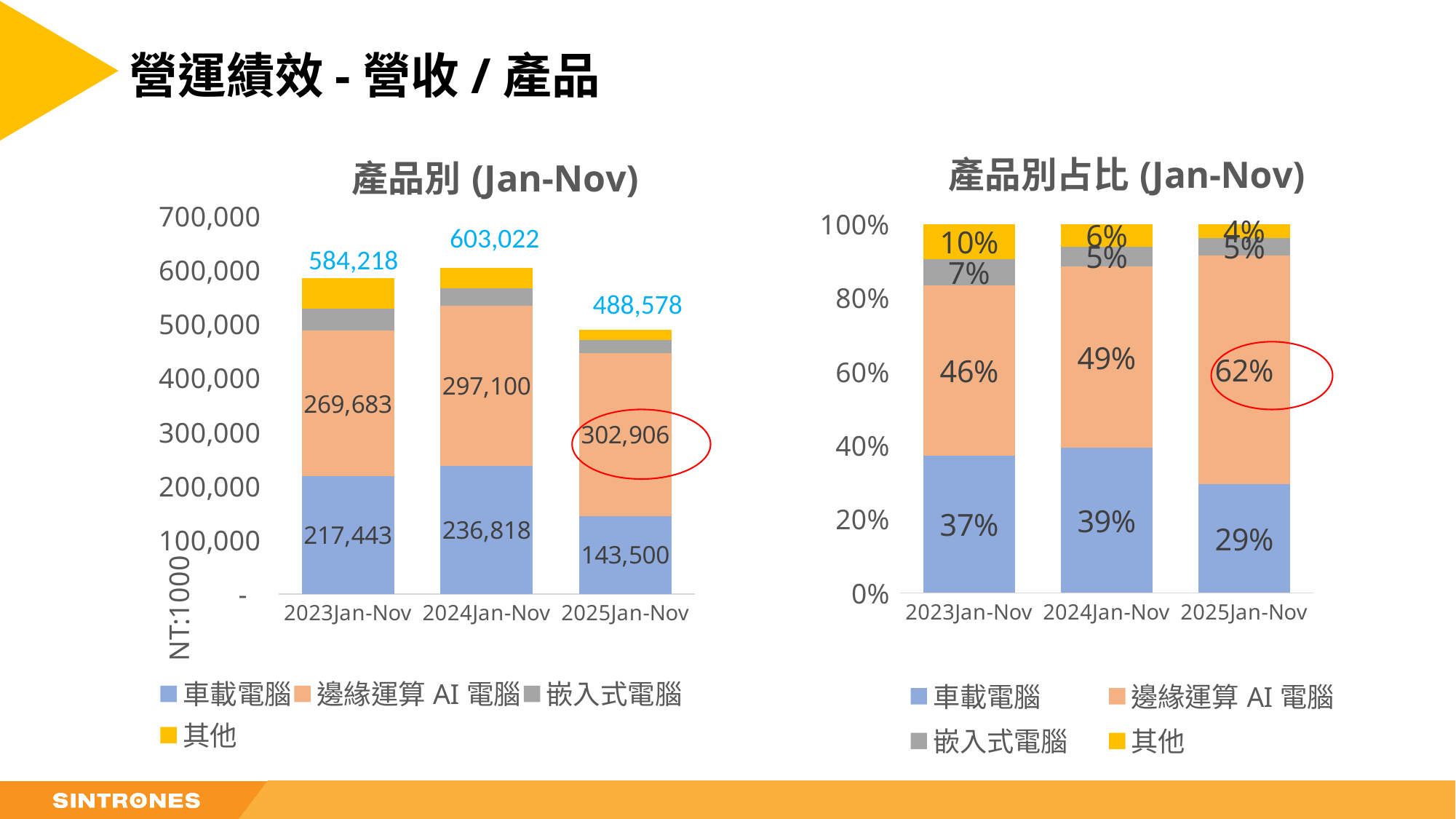
In the 產品別 (Jan-Nov) chart, is the 車載電腦 value for 2024Jan-Nov larger or smaller than for 2023Jan-Nov? larger In the 產品別 (Jan-Nov) chart, which period has the lowest total? 2025Jan-Nov In the 產品別占比 (Jan-Nov) chart, what is the share of 其他 in 2023Jan-Nov? 10% In the 產品別 (Jan-Nov) chart, what is the total value shown above the 2024Jan-Nov bar? 603,022 In the 產品別 (Jan-Nov) chart, how many series does the legend list? 4 In the 產品別占比 (Jan-Nov) chart, what is the share of 邊緣運算 AI 電腦 in 2025Jan-Nov? 62% In the 產品別 (Jan-Nov) chart, what is the value for 車載電腦 in 2025Jan-Nov? 143,500 In the 產品別占比 (Jan-Nov) chart, does the share of 邊緣運算 AI 電腦 rise or fall from 2023Jan-Nov to 2025Jan-Nov? rise In the 產品別占比 (Jan-Nov) chart, how many periods are shown on the x axis? 3 In the 產品別 (Jan-Nov) chart, what is the difference between the 邊緣運算 AI 電腦 values for 2024Jan-Nov and 2023Jan-Nov? 27,417 In the 產品別 (Jan-Nov) chart, what is the value for 邊緣運算 AI 電腦 in 2023Jan-Nov? 269,683 What kind of chart is the 產品別占比 (Jan-Nov) chart? stacked bar chart